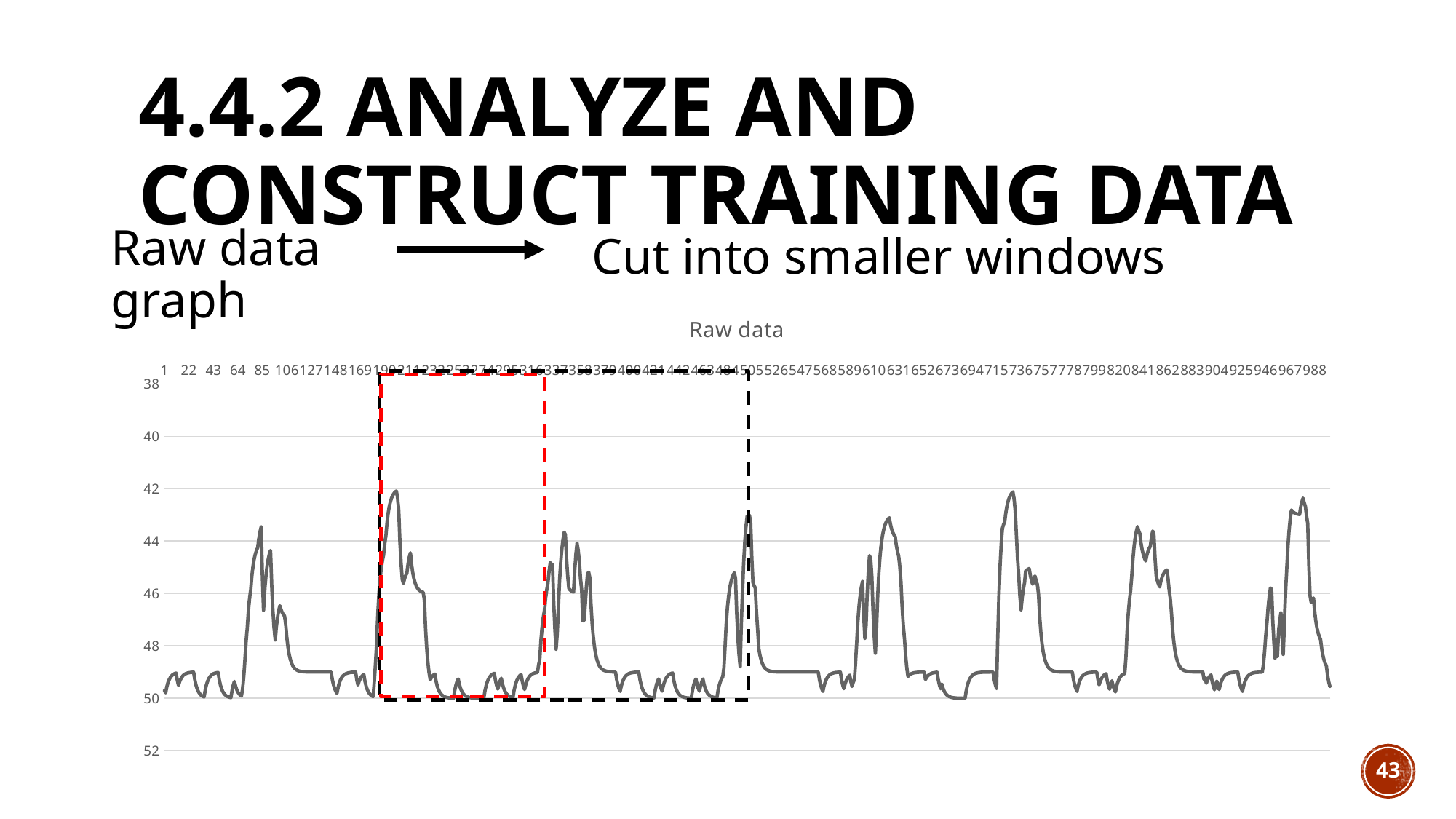
Is the highest value reached by the line greater or less than 48? greater How many dashed rectangles are drawn over the chart? 2 What kind of chart is shown on the slide? line chart How many data series are plotted in the chart? 1 What is the last label on the x axis of the chart? 988 What is the value of the bottommost tick on the y axis? 52 What is the value of the topmost tick on the y axis? 38 What is the first label on the x axis of the chart? 1 Is the lowest value reached by the line greater or less than 44? less How many tick labels are shown on the y axis? 8 What is the title of the chart? Raw data